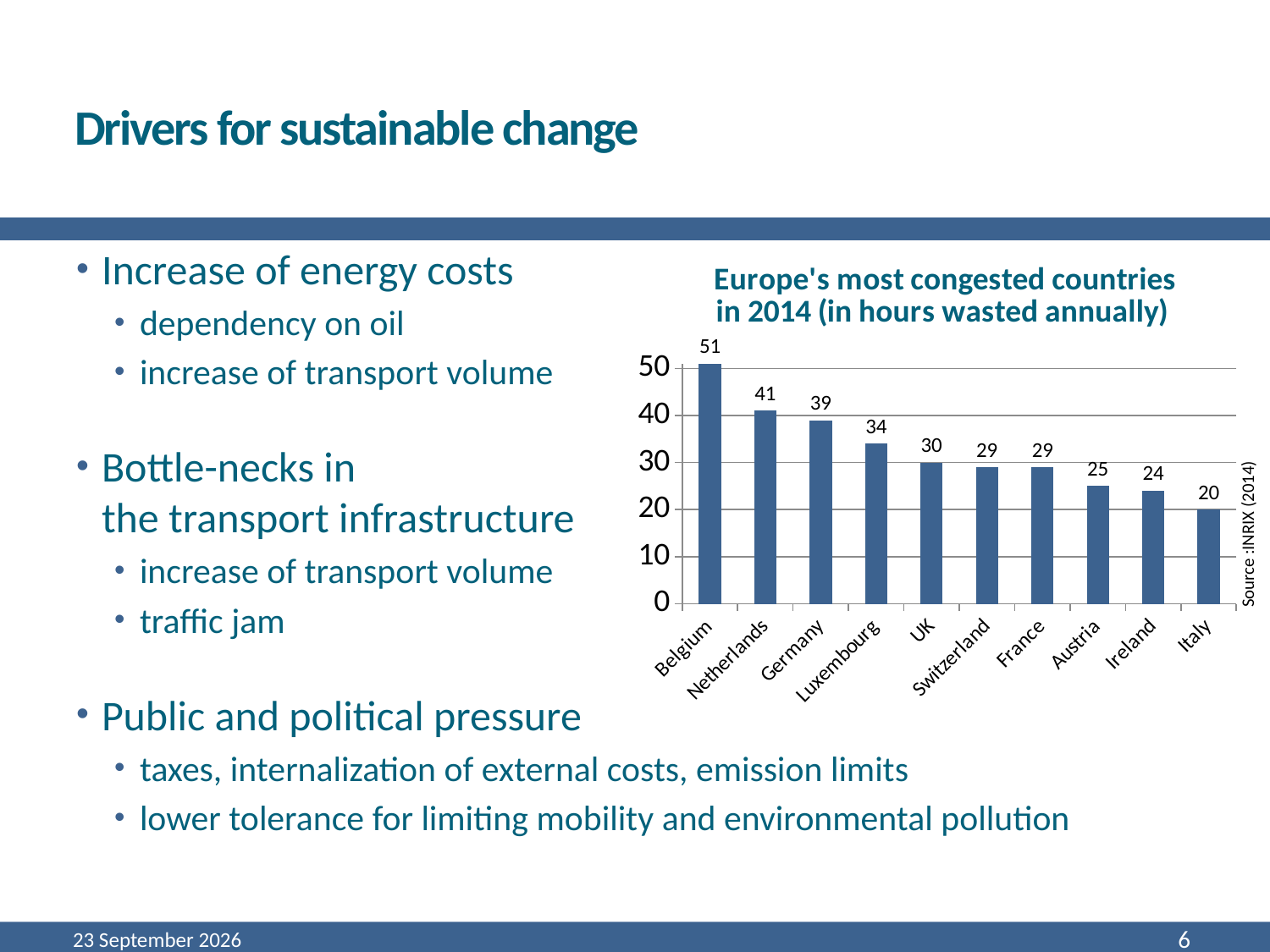
What is the value for Belgium? 51 Which country has the lowest number of hours wasted annually? Italy Which has a larger value, the UK or Austria? UK What is the value for Ireland? 24 How many countries are shown in the chart? 10 Which country has the highest number of hours wasted annually? Belgium What is the difference between the values for Germany and Italy? 19 Is the value for Germany greater or less than 30? greater What kind of chart is shown on the slide? Bar chart What is the difference between the values for Belgium and the Netherlands? 10 What is the title of the chart? Europe's most congested countries in 2014 (in hours wasted annually) What is the value for Luxembourg? 34